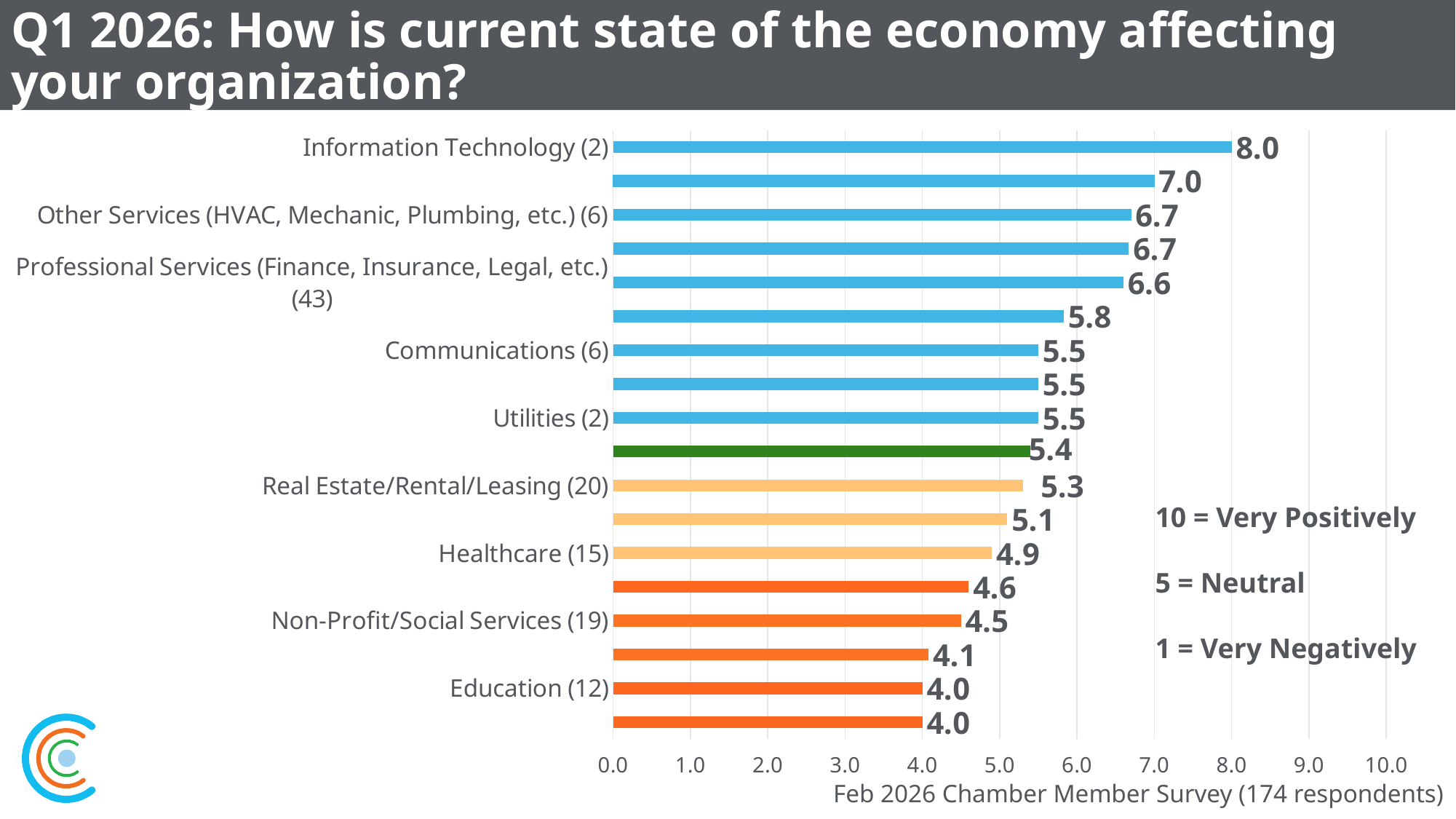
What kind of chart is shown on the slide? bar chart What is the value for Education (12)? 4.0 How many bars are plotted in the chart? 18 Which labeled category has the highest value? Information Technology (2) Which has a larger value, Real Estate/Rental/Leasing (20) or Non-Profit/Social Services (19)? Real Estate/Rental/Leasing (20) What is the value for Healthcare (15)? 4.9 What is the difference between the values for Information Technology (2) and Education (12)? 4.0 What is the value for Information Technology (2)? 8.0 What is the value for Communications (6)? 5.5 What is the value for Other Services (HVAC, Mechanic, Plumbing, etc.) (6)? 6.7 What is the value for Professional Services (Finance, Insurance, Legal, etc.) (43)? 6.6 Is the value for Utilities (2) greater or less than 5.0? greater